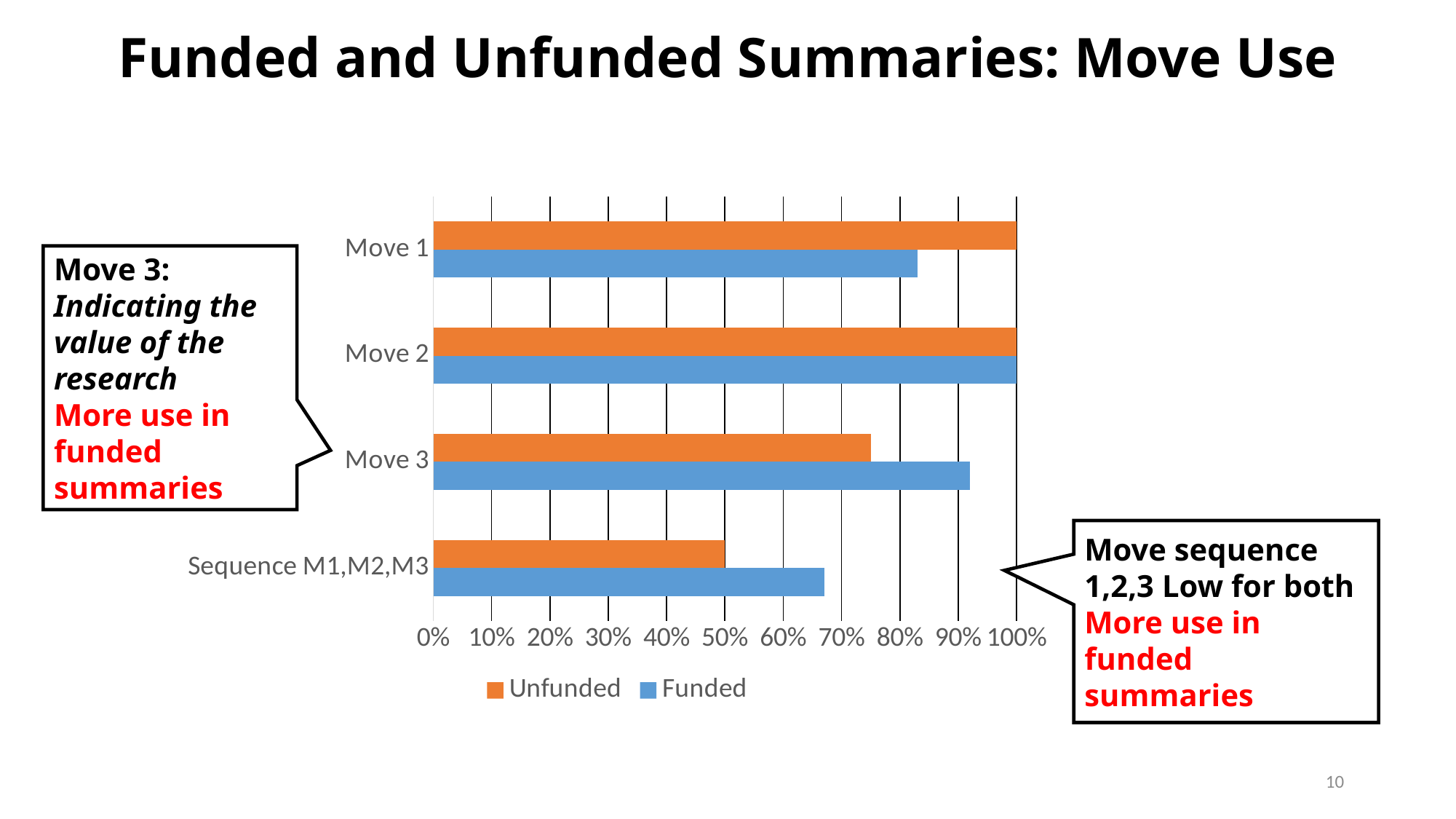
How many categories are plotted on the chart? 4 What is the Funded value for Move 2? 100% How many series does the legend list? 2 For Move 3, which is larger: the Funded value or the Unfunded value? Funded Is the Unfunded value for Move 3 greater or less than 70%? greater Is the Funded value for Move 1 greater or less than 90%? less Is the Funded value for Sequence M1,M2,M3 greater or less than 60%? greater Which category has the lowest Unfunded value? Sequence M1,M2,M3 What is the Unfunded value for Sequence M1,M2,M3? 50% What is the Unfunded value for Move 1? 100% What kind of chart is shown on the slide? bar chart